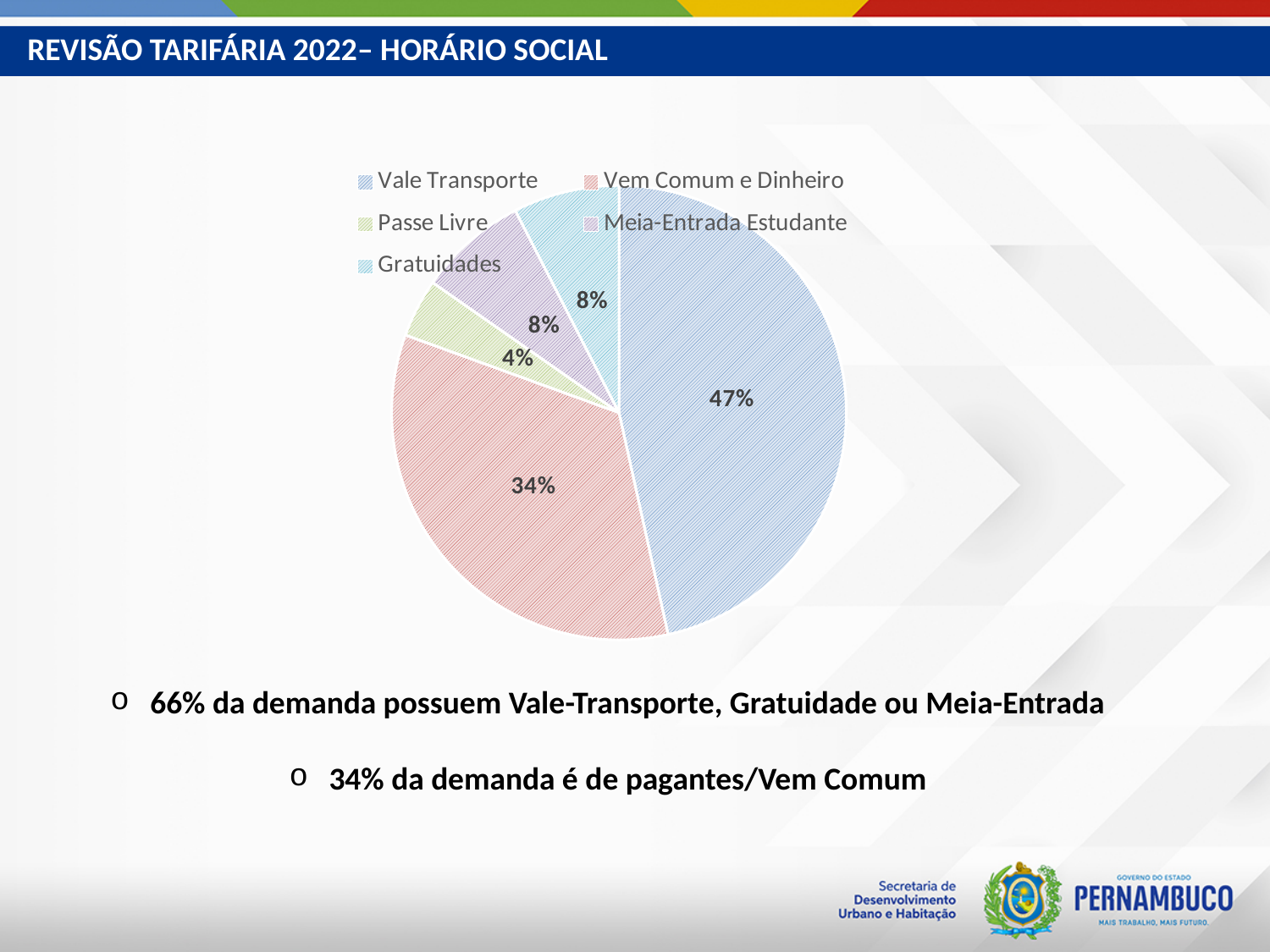
How many categories does the legend of the pie chart list? 5 Which category has the largest slice of the pie? Vale Transporte What type of chart is shown on the slide? pie chart What share of the pie does Meia-Entrada Estudante represent? 8% What is the combined share of Meia-Entrada Estudante and Gratuidades? 16% What share of the pie does Vale Transporte represent? 47% What share of the pie does Passe Livre represent? 4% What is the difference in percentage points between Vale Transporte and Vem Comum e Dinheiro? 13 What share of the pie does Gratuidades represent? 8% What share of the pie does Vem Comum e Dinheiro represent? 34% Which category has the smallest slice of the pie? Passe Livre Which is larger, the slice for Vem Comum e Dinheiro or the slice for Gratuidades? Vem Comum e Dinheiro